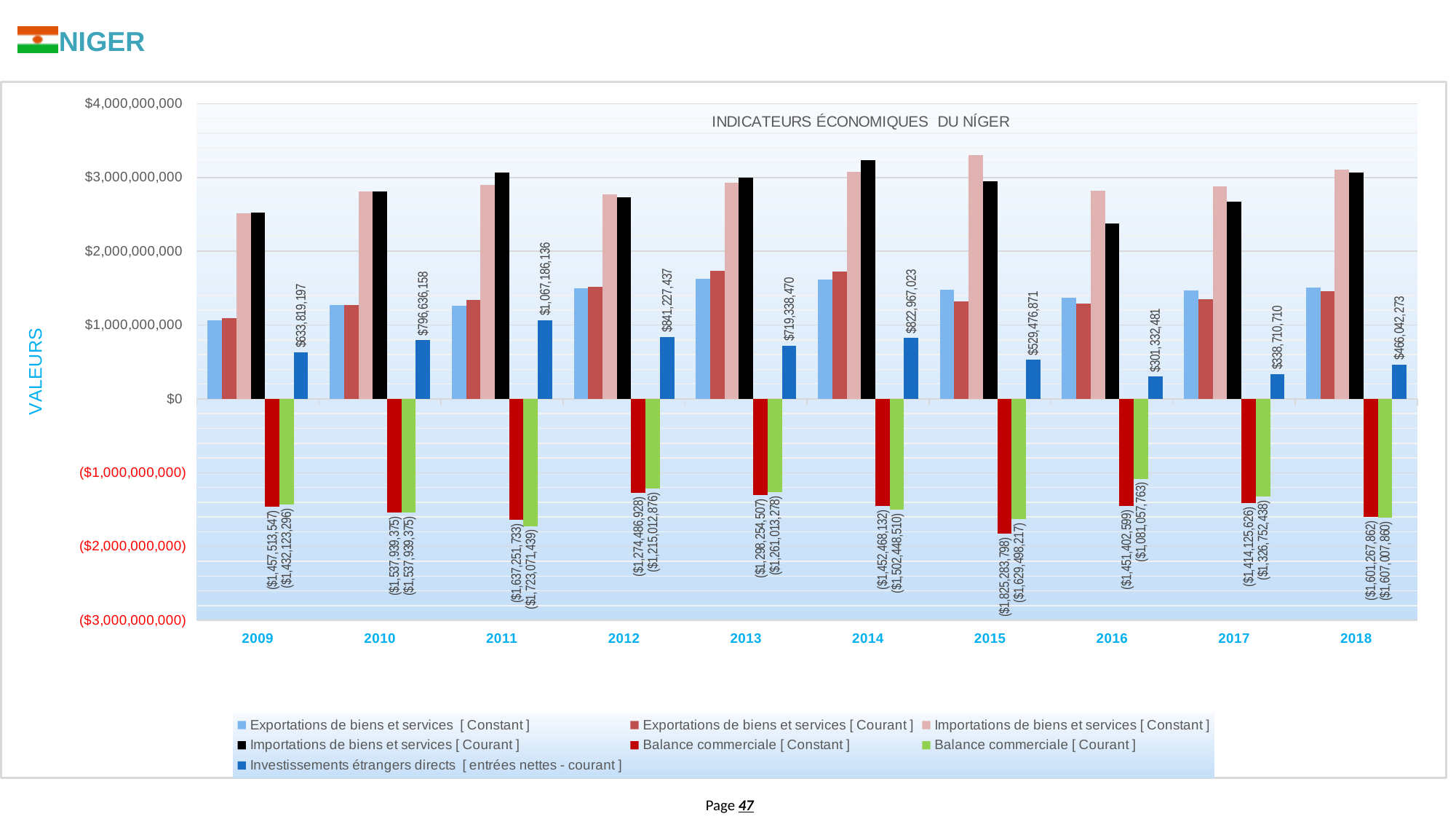
What is the value of Balance commerciale [Constant] for 2015? ($1,825,283,798) What is the value of Investissements étrangers directs [entrées nettes - courant] for 2011? $1,067,186,136 What is the value of Investissements étrangers directs [entrées nettes - courant] for 2016? $301,332,481 How many series does the legend list? 7 What kind of chart is shown on the slide? bar chart Which year has the larger value for Investissements étrangers directs, 2012 or 2014? 2012 What is the value of Balance commerciale [Courant] for 2016? ($1,081,057,763) What is the difference between Investissements étrangers directs in 2011 and in 2016? $765,853,655 In which year is Investissements étrangers directs [entrées nettes - courant] the lowest? 2016 Is the value for Importations de biens et services [Courant] in 2016 greater or less than $3,000,000,000? less How many years are shown on the x axis? 10 In which year is Investissements étrangers directs [entrées nettes - courant] the highest? 2011